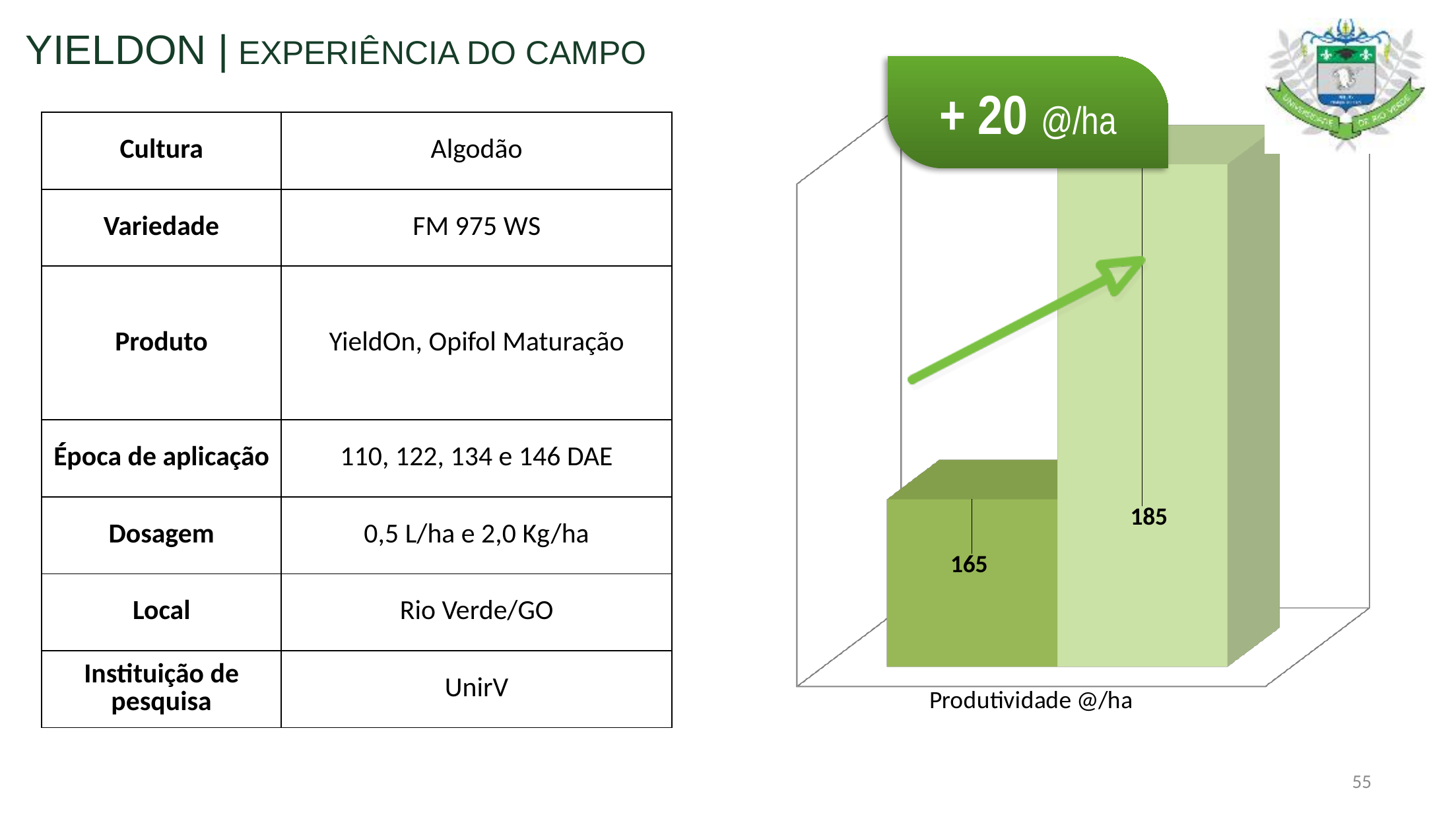
What value is printed on the right (lighter green) bar of the chart? 185 What gain is stated in the green callout above the chart? + 20 @/ha What value is printed on the left (darker green) bar of the chart? 165 How many bars are plotted in the chart? 2 Which bar in the chart has the higher value, the left or the right one? the right one What kind of chart is shown on the right side of the slide? bar chart Is the value of the right bar larger or smaller than the value of the left bar? larger What is the axis label printed below the bars in the chart? Produtividade @/ha Which bar in the chart has the lower value, the left or the right one? the left one What is the difference between the two bar values shown in the chart? 20 Do the bar values rise or fall from left to right in the chart? rise